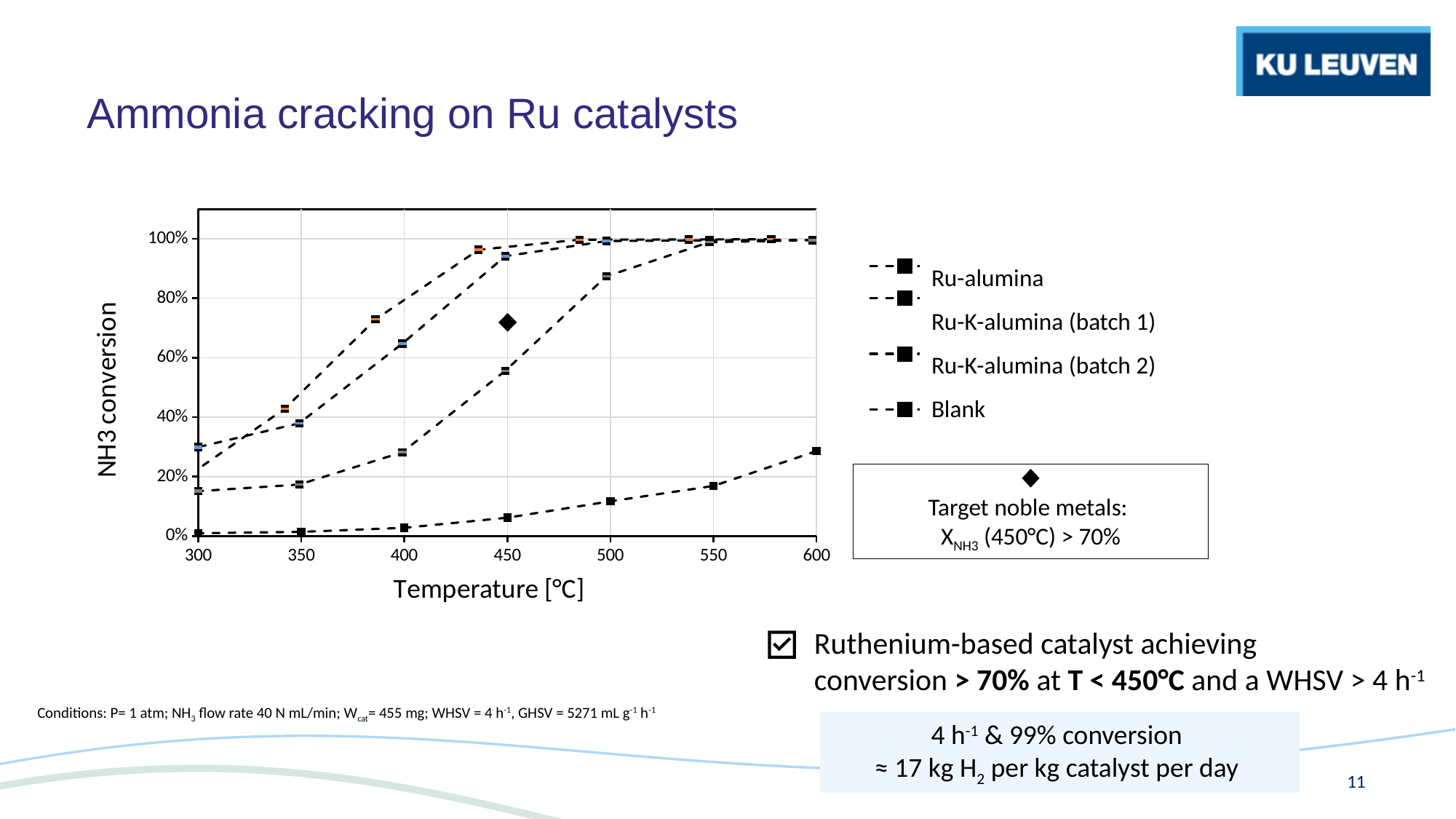
Do the NH3 conversion curves rise or fall as temperature increases along the x axis? rise How many temperature tick values are shown on the x axis of the chart? 7 Is the value of the highest curve at 450°C greater or less than 80%? greater How many series does the chart legend list? 4 What is the highest value shown on the y axis of the chart? 100% What kind of chart is shown on the slide? line chart Is the value of the highest curve at 300°C greater or less than 40%? less What are the four series named in the chart legend? Ru-alumina, Ru-K-alumina (batch 1), Ru-K-alumina (batch 2), Blank What conversion target does the diamond marker at 450°C represent? > 70% Is the value of the lowest curve at 600°C greater or less than 40%? less What is the label of the y-axis of the chart? NH3 conversion What is the highest temperature shown on the x axis of the chart? 600